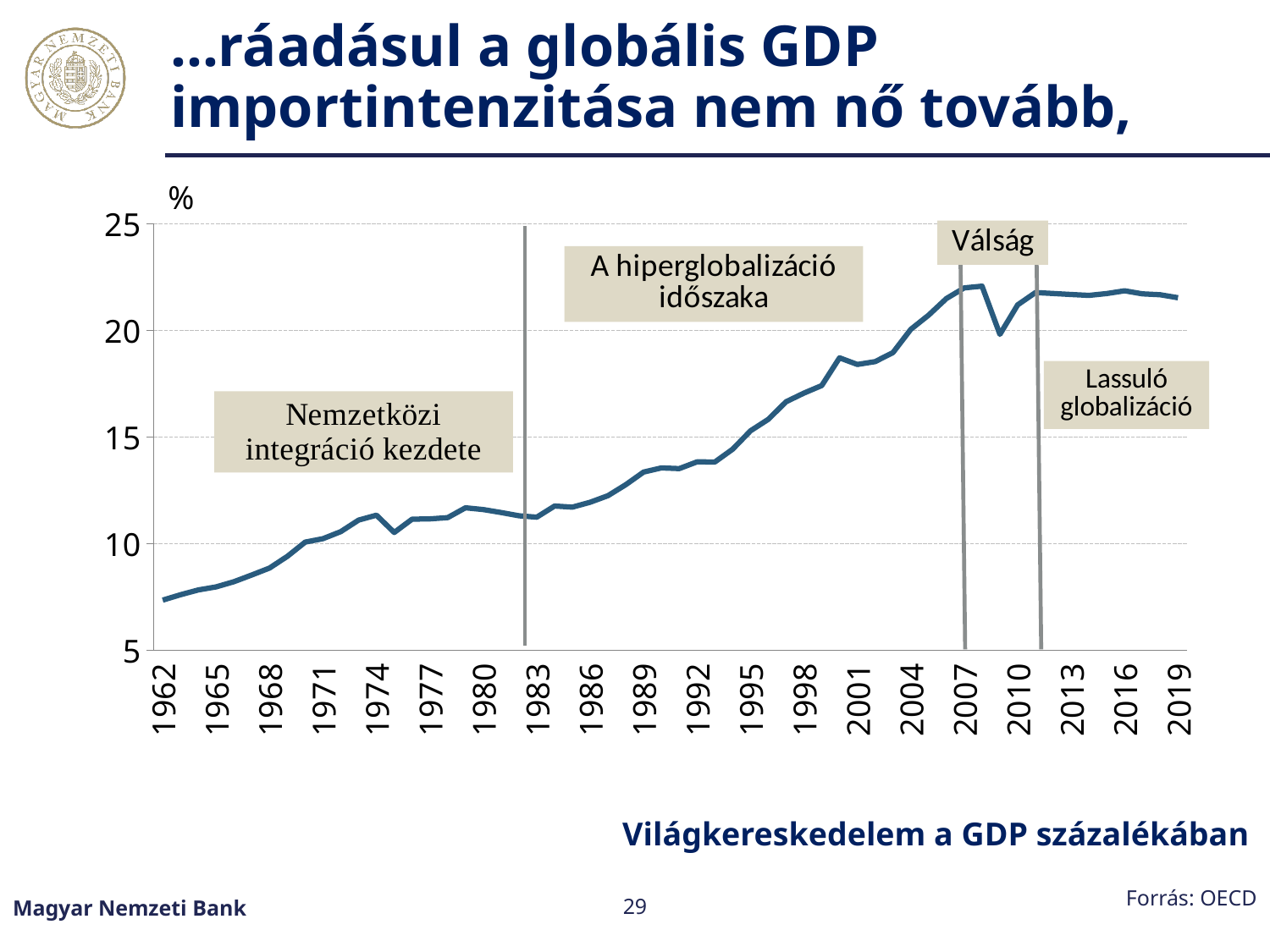
Does the line generally rise or fall from 1962 to 2007? rise Is the value for 1962 greater or less than 10? less What is the title of the chart, shown below it? Világkereskedelem a GDP százalékában Is the value for 2007 greater or less than 20? greater What kind of chart is shown on the slide? line chart What is the source of the chart data? OECD Is the value for 1989 greater or less than 15? less Which year has the lowest value on the chart? 1962 Which is larger, the value for 2001 or the value for 1989? 2001